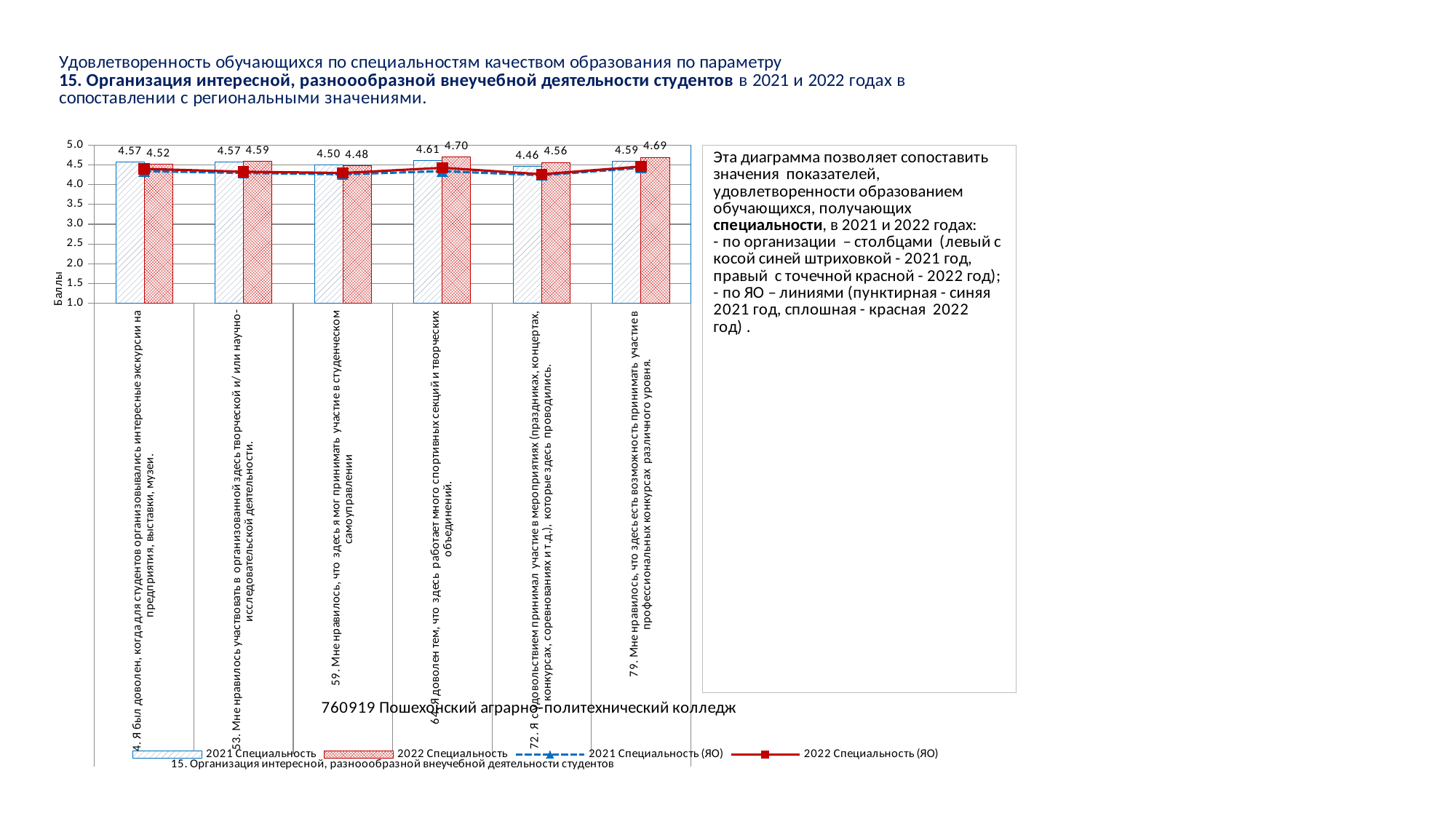
What is the 2022 Специальность value for item 72 (Я с удовольствием принимал участие в мероприятиях)? 4.56 Which item has the highest 2022 Специальность value? 64. Я доволен тем, что здесь работает много спортивных секций и творческих объединений. What kind of chart is this? Combined bar and line chart How many series does the legend list? 4 What is the 2022 Специальность value for item 4 (Я был доволен, когда для студентов организовывались интересные экскурсии)? 4.52 Which item has the lowest 2021 Специальность value? 72. Я с удовольствием принимал участие в мероприятиях (праздниках, концертах, конкурсах, соревнованиях и т.д.), которые здесь проводились. How many items (categories) are shown on the x axis? 6 What is the 2021 Специальность value for item 64 (Я доволен тем, что здесь работает много спортивных секций и творческих объединений)? 4.61 For item 59, which is larger: the 2021 Специальность value or the 2022 Специальность value? 2021 Специальность Is the 2021 Специальность (ЯО) line value for item 64 greater or less than 4.0? greater What is the difference between the 2022 and 2021 Специальность values for item 79? 0.10 What is the label of the vertical axis? Баллы